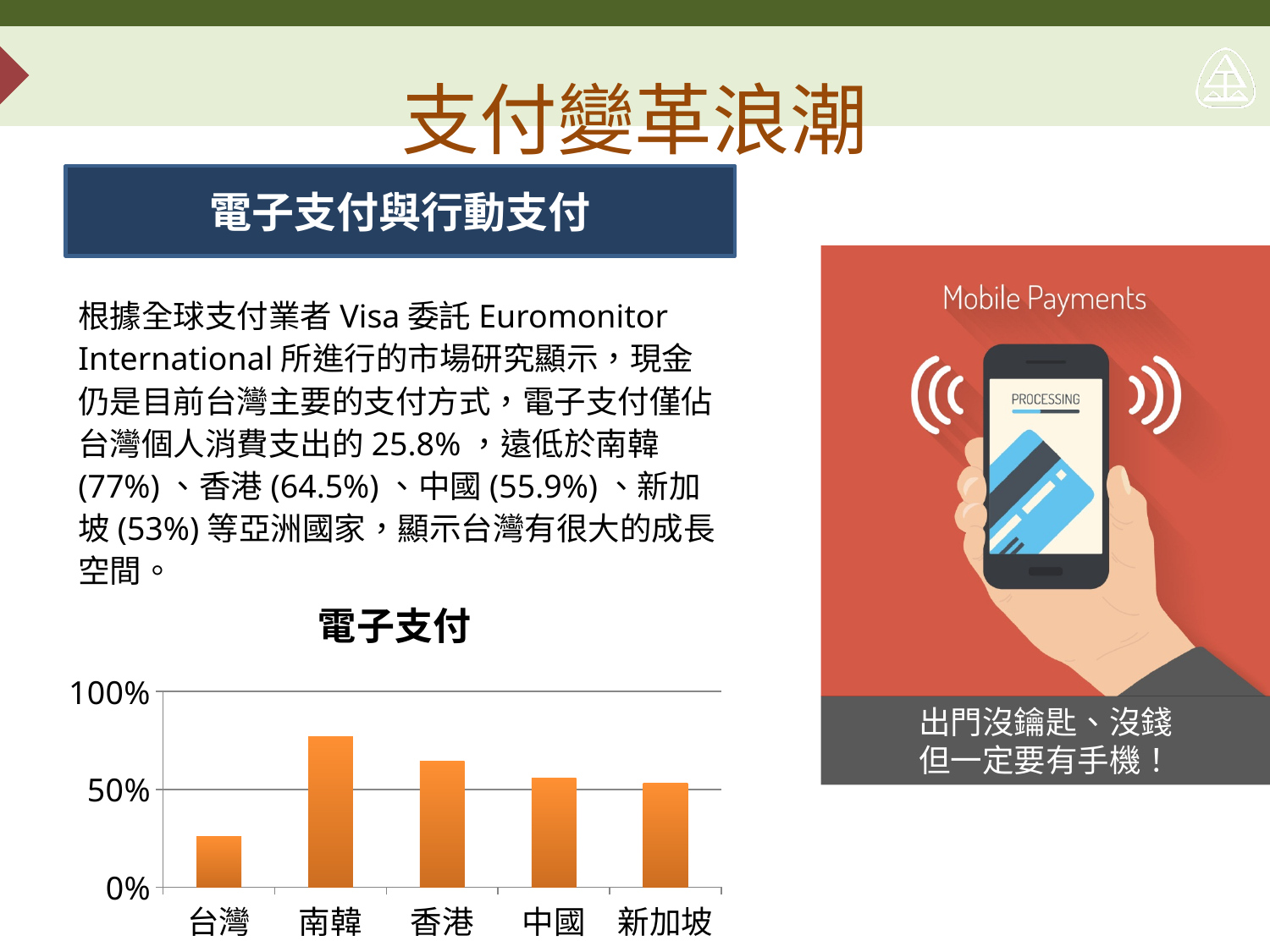
Moving from 南韓 to 新加坡 along the x axis, do the bar values rise or fall? fall What is the title of the chart? 電子支付 Is the value for 南韓 greater or less than 50%? greater Which is larger, the value for 南韓 or the value for 香港? 南韓 What kind of chart is shown on the slide? bar chart Is the value for 南韓 greater or less than 100%? less Which is larger, the value for 台灣 or the value for 新加坡? 新加坡 How many categories are shown on the x axis of the chart? 5 Which category has the lowest bar in the chart? 台灣 Which category has the highest bar in the chart? 南韓 Is the value for 香港 greater or less than 50%? greater